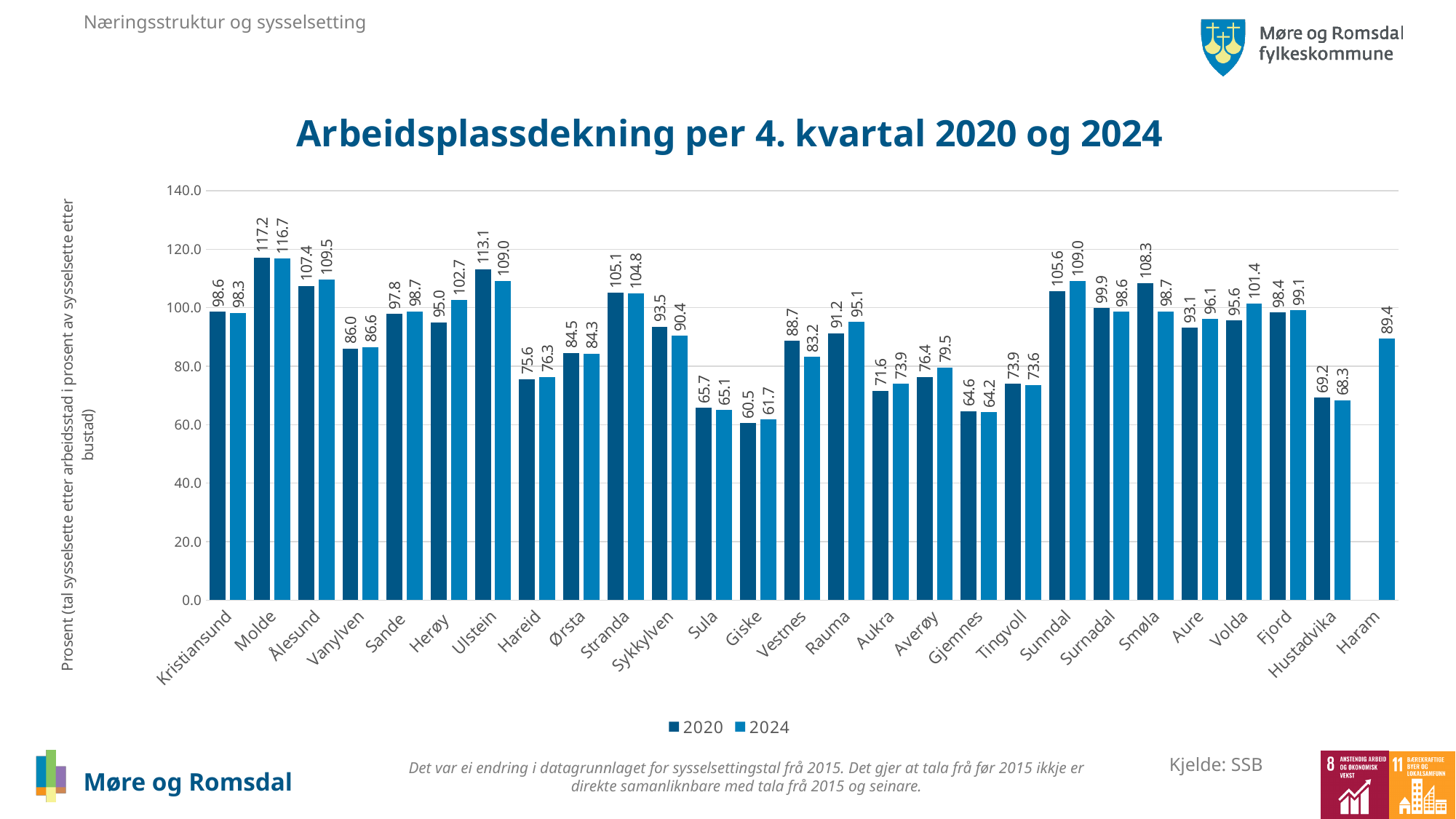
Which is larger for Ulstein, the 2020 value or the 2024 value? 2020 What is the 2024 value for Herøy? 102.7 How much higher is Herøy's 2024 value than its 2020 value? 7.7 What type of chart is shown on the slide? Bar chart What is the 2020 value for Sunndal? 105.6 What is the 2024 value for Haram? 89.4 How many series does the legend list? 2 Is the 2024 value for Volda greater or less than 100? greater How many municipalities are shown on the x axis? 27 By how much did Smøla's value fall from 2020 to 2024? 9.6 Which municipality has the lowest 2024 value? Giske Which municipality has the highest 2020 value? Molde